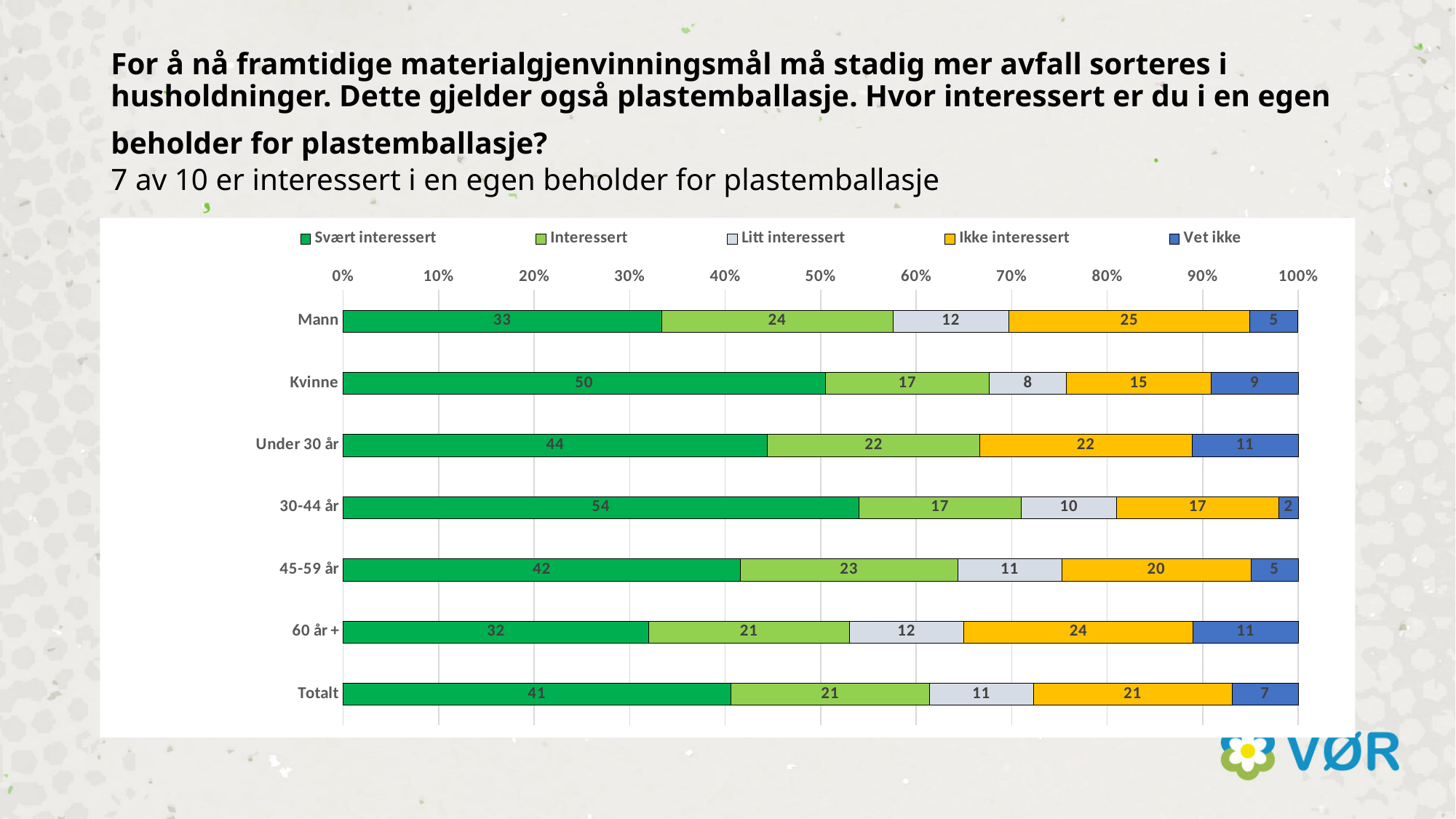
What is the total of the labelled segments in the Mann bar? 99 Which has the larger Ikke interessert value, 60 år + or 45-59 år? 60 år + What is the difference between the Svært interessert values for Kvinne and Mann? 17 What is the value for Ikke interessert in the Mann bar? 25 Which category has the highest value for Svært interessert? 30-44 år Is the Svært interessert segment for 30-44 år greater or less than 50%? greater Which category has the lowest value for Svært interessert? 60 år + How many series does the legend list? 5 What is the value for Vet ikke in the 30-44 år bar? 2 How many categories (bars) are shown in the chart? 7 What is the value for Svært interessert in the Kvinne bar? 50 What kind of chart is shown on the slide? Stacked bar chart